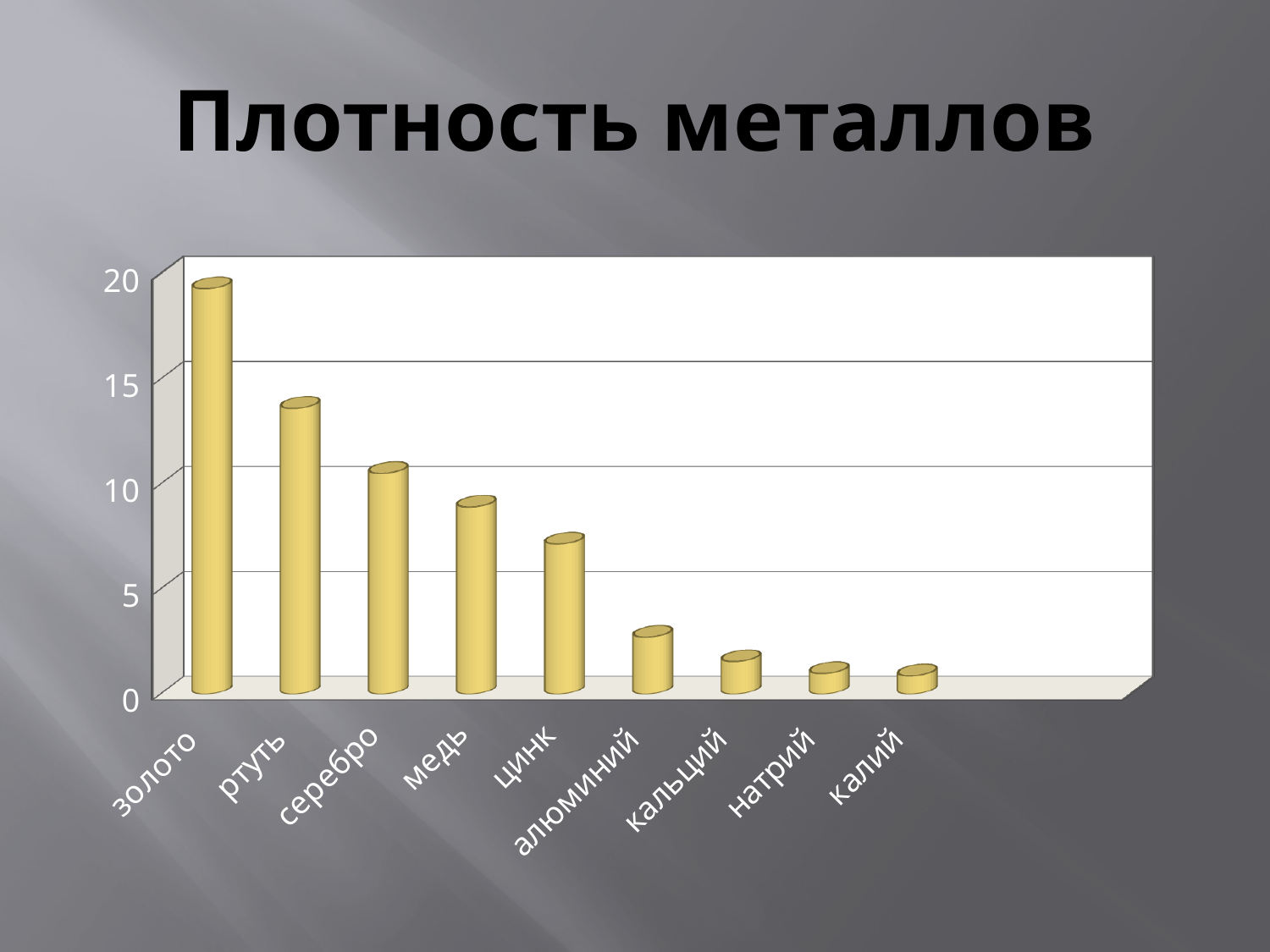
Is the value for алюминий greater or less than 5? less Is the value for золото greater or less than 15? greater Is the value for ртуть greater or less than 10? greater How many metals (categories) are shown on the x axis? 9 What is the title of the chart? Плотность металлов Do the bar values rise or fall from left to right along the x axis? fall What kind of chart is shown on the slide? bar chart Which metal has the highest bar? золото Which has the larger value, золото or ртуть? золото Which has the larger value, алюминий or кальций? алюминий